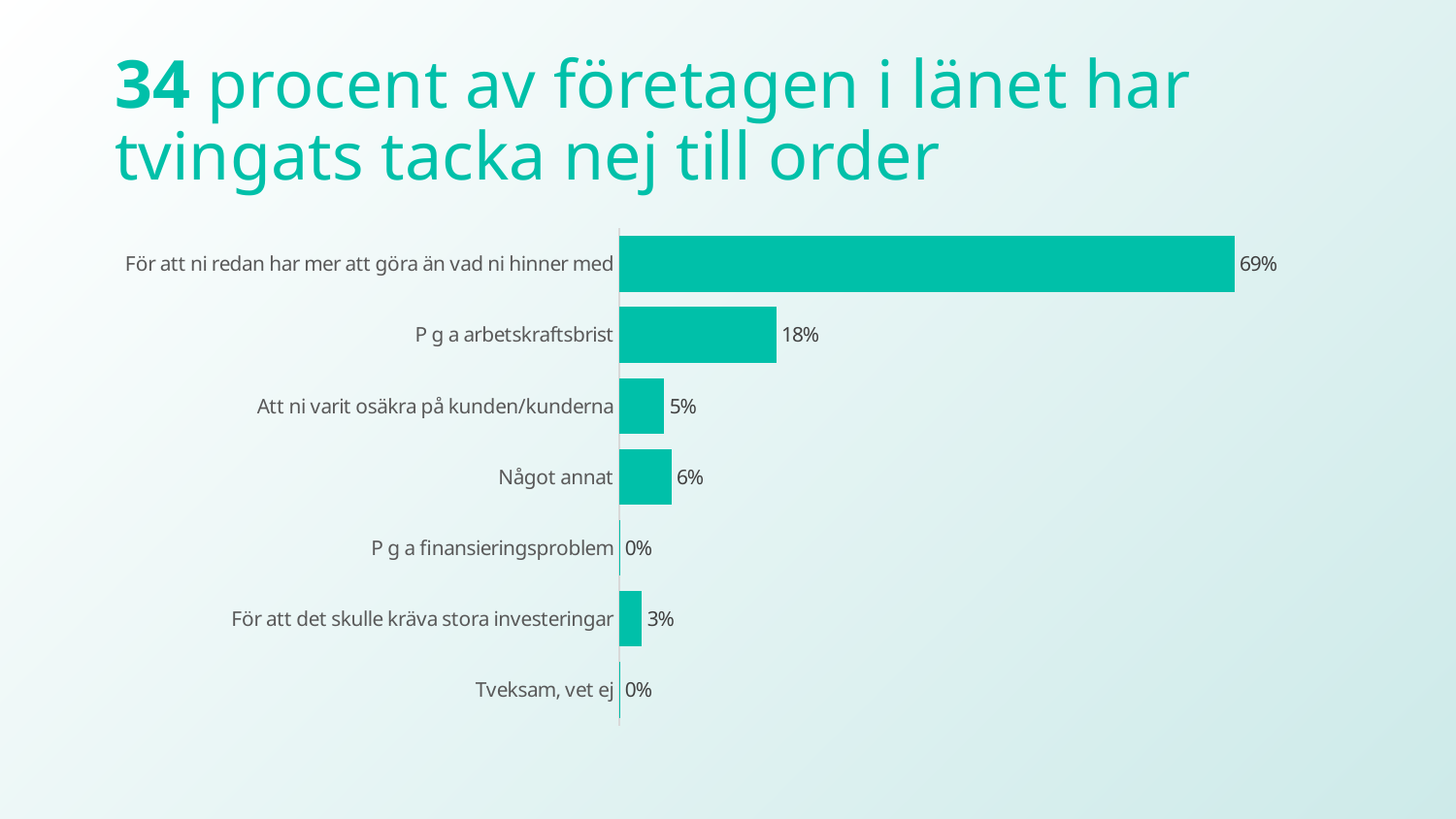
What is the value for "P g a arbetskraftsbrist"? 18% What is the value for "Att ni varit osäkra på kunden/kunderna"? 5% What kind of chart is shown on the slide? Bar chart Which category has the highest value? För att ni redan har mer att göra än vad ni hinner med What is the value for "För att det skulle kräva stora investeringar"? 3% Which is larger, the value for "Något annat" or the value for "För att det skulle kräva stora investeringar"? Något annat How many categories are shown in the chart? 7 What is the value for "P g a finansieringsproblem"? 0% What is the difference between the values for "Något annat" and "Att ni varit osäkra på kunden/kunderna"? 1% What is the value for "Något annat"? 6% How many categories have a value of 0%? 2 What is the difference between the values for "För att ni redan har mer att göra än vad ni hinner med" and "P g a arbetskraftsbrist"? 51%